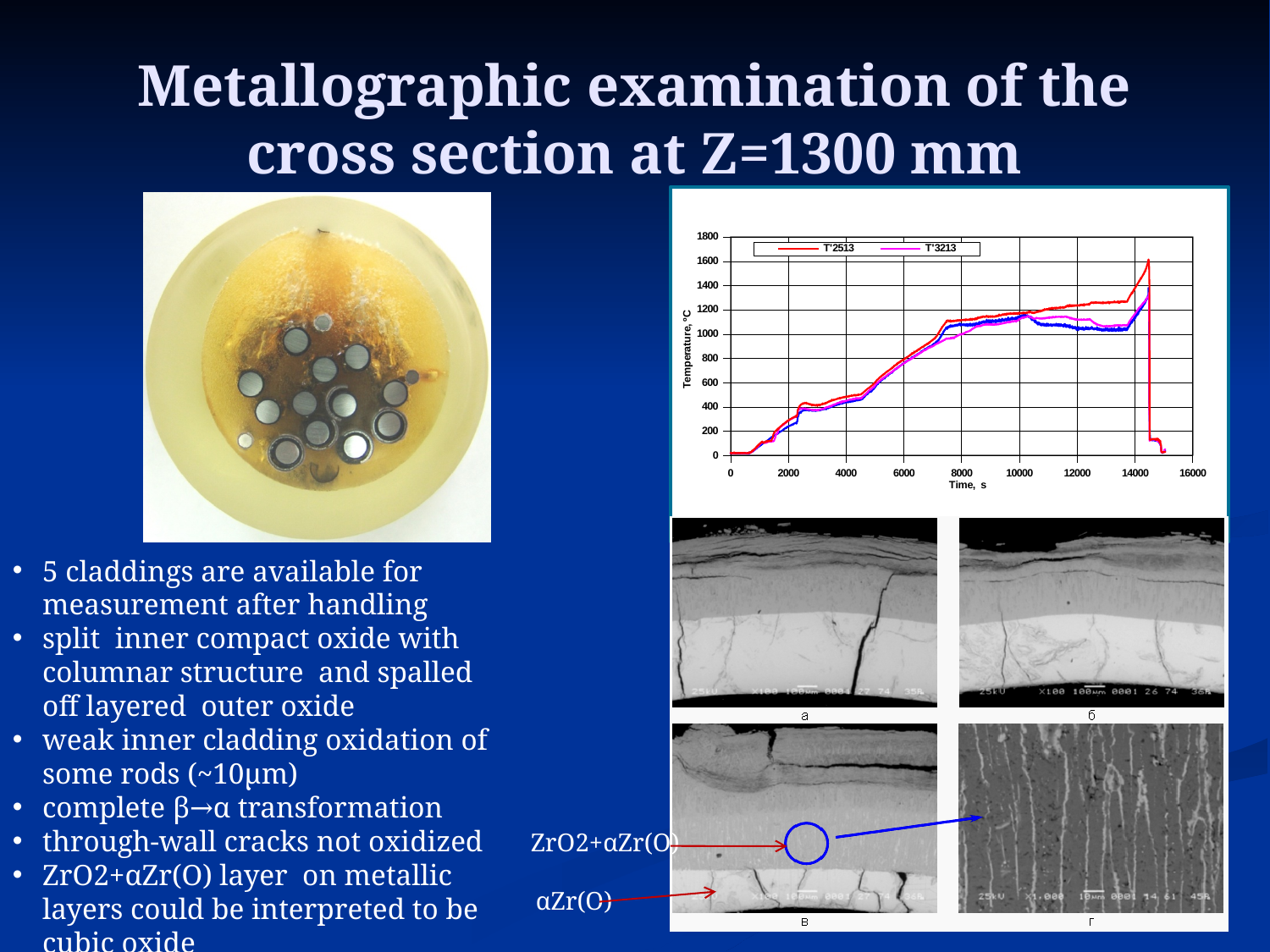
What are the names of the two series in the chart legend? T'2513 and T'3213 Do the temperature values generally rise or fall along the time axis between 0 and 14000 s? rise Is the peak value of the T'3213 series greater or less than 1400? less What kind of chart is shown on the slide? line chart Which series reaches the highest peak temperature in the chart? T'2513 Is the value of T'2513 at 10000 s greater or less than 1000? greater What is the highest tick value shown on the time axis of the chart? 16000 What is the label of the vertical axis of the chart? Temperature, °C How many series does the chart legend list? 2 At 12000 s, which series has the higher temperature, T'2513 or T'3213? T'2513 Is the value of T'2513 at 2000 s greater or less than 600? less